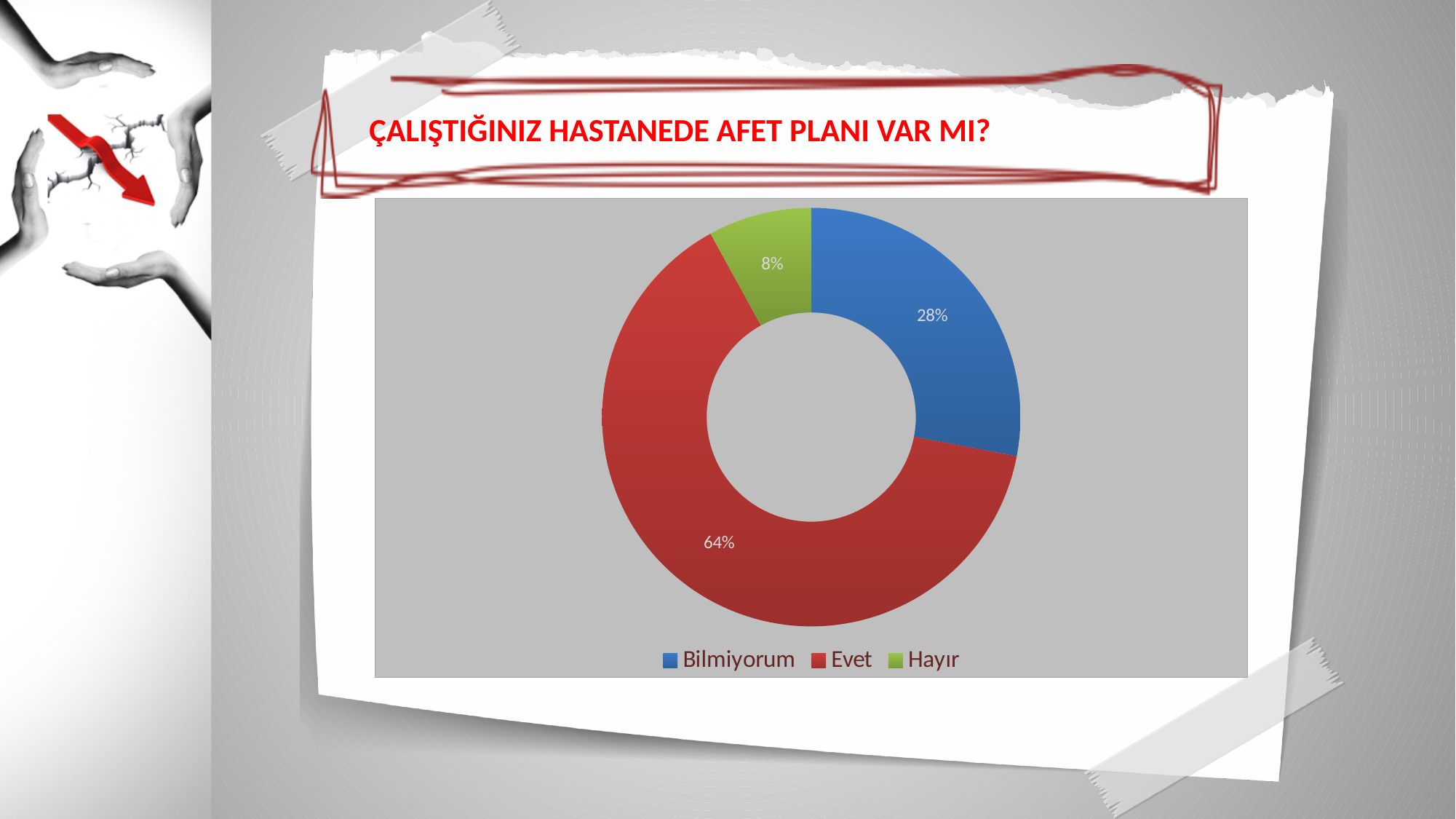
What is the title of the slide above the chart? ÇALIŞTIĞINIZ HASTANEDE AFET PLANI VAR MI? What is the difference in percentage points between Evet and Bilmiyorum? 36 What kind of chart is shown on the slide? Doughnut (pie) chart How many categories does the chart show? 3 What colour represents Evet in the chart? Red What percentage of respondents answered Hayır? 8% What percentage of respondents answered Evet? 64% What percentage of respondents answered Bilmiyorum? 28% Which is larger, the share for Bilmiyorum or the share for Hayır? Bilmiyorum What is the difference in percentage points between Bilmiyorum and Hayır? 20 Which response has the largest share of the chart? Evet Which response has the smallest share of the chart? Hayır